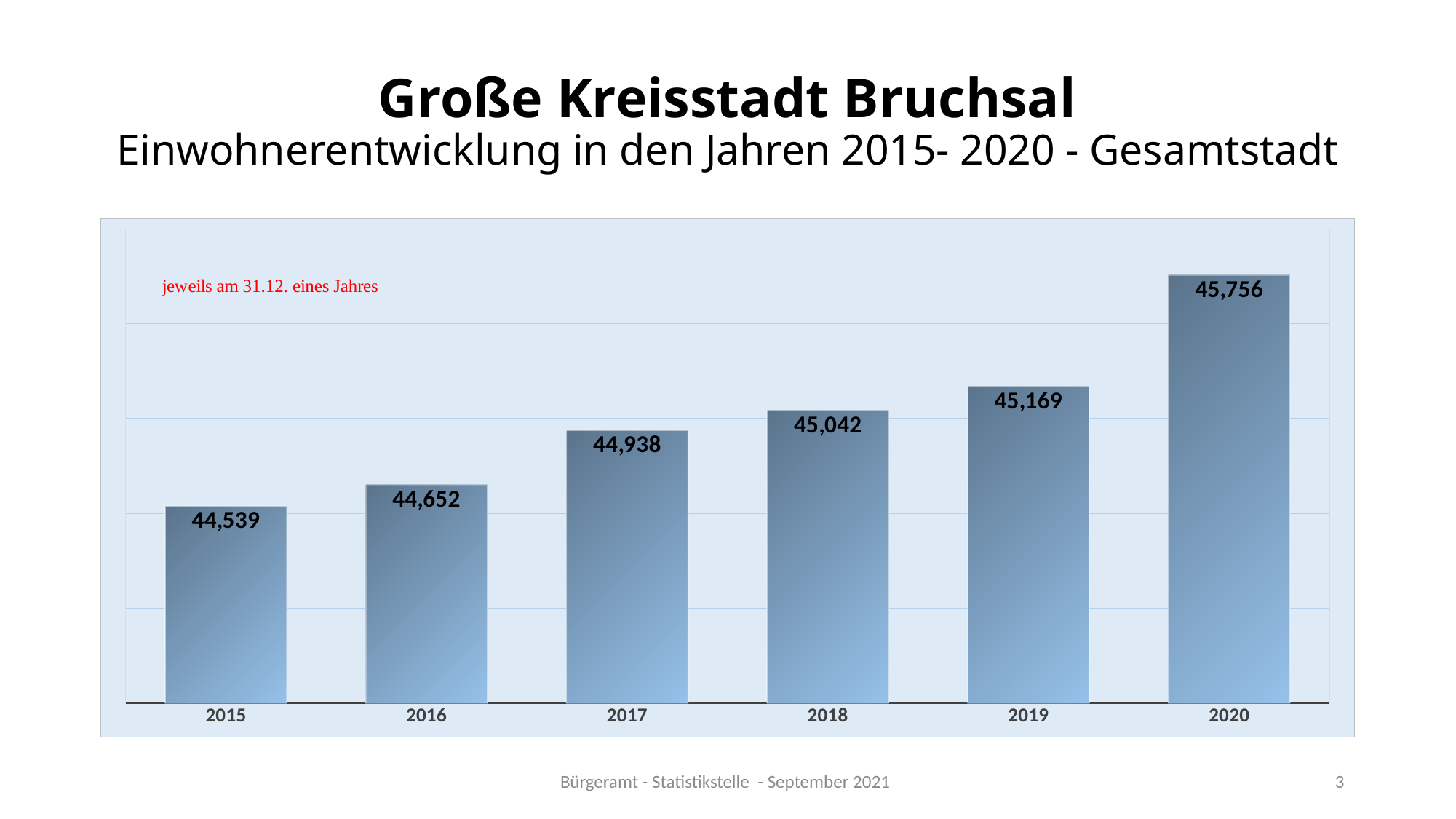
What is the population value shown for 2017? 44,938 What is the value for 2015? 44,539 Which is larger, the value for 2018 or the value for 2016? 2018 What does the red note inside the chart say? jeweils am 31.12. eines Jahres Which year has the highest value? 2020 Do the values rise or fall from 2015 to 2020? Rise By how much did the value increase from 2015 to 2020? 1,217 What value is shown for the year 2020? 45,756 How many years are shown on the x axis? 6 What is the difference between the values for 2020 and 2019? 587 Which year has the lowest value? 2015 What kind of chart is shown on the slide? Bar chart